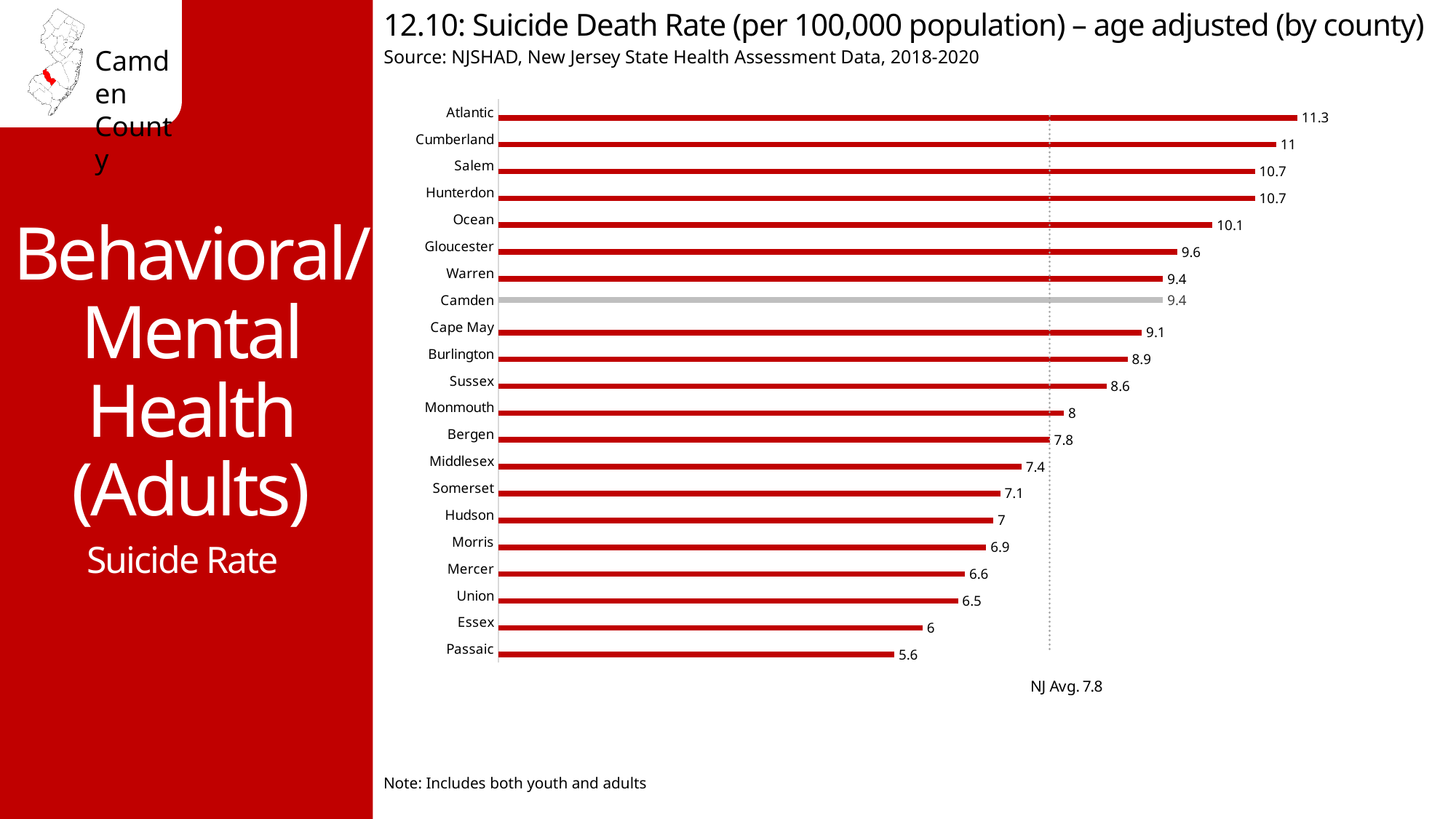
How many counties are shown in the chart? 21 What is the NJ average suicide death rate shown on the chart? 7.8 What is the suicide death rate for Passaic County? 5.6 Which county has the lowest suicide death rate? Passaic What kind of chart is shown on the slide? Bar chart What is the suicide death rate for Atlantic County? 11.3 Which county has the highest suicide death rate? Atlantic What is the difference between the suicide death rates of Atlantic and Passaic counties? 5.7 What is the suicide death rate for Camden County? 9.4 What is the difference between the suicide death rate of Camden County and the NJ average? 1.6 Which county has a higher suicide death rate, Ocean or Gloucester? Ocean Which county's bar is shown in gray rather than red? Camden